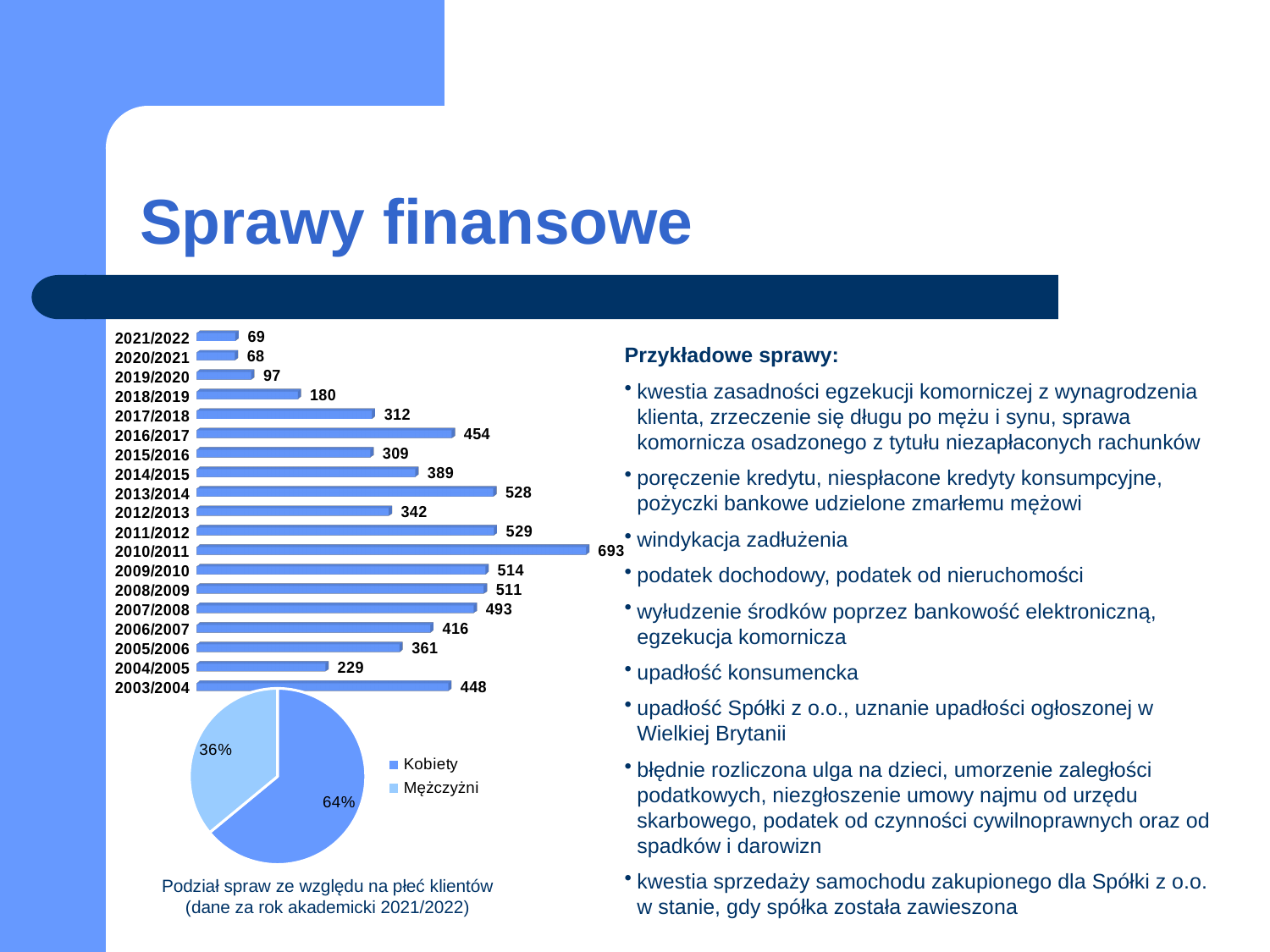
How many academic years are shown in the bar chart? 19 In the bar chart, which academic year has the highest value? 2010/2011 In the pie chart, what share is Kobiety? 64% In the bar chart, which is larger, the value for 2013/2014 or the value for 2012/2013? 2013/2014 In the pie chart, what share is Mężczyźni? 36% In the bar chart, which academic year has the lowest value? 2020/2021 What kind of chart shows the values by academic year? Bar chart In the bar chart, what is the value for 2003/2004? 448 In the bar chart, what is the difference between the values for 2016/2017 and 2015/2016? 145 How many entries does the legend of the pie chart list? 2 In the bar chart, do the values rise or fall from 2017/2018 to 2021/2022? Fall In the bar chart, what is the value for 2010/2011? 693